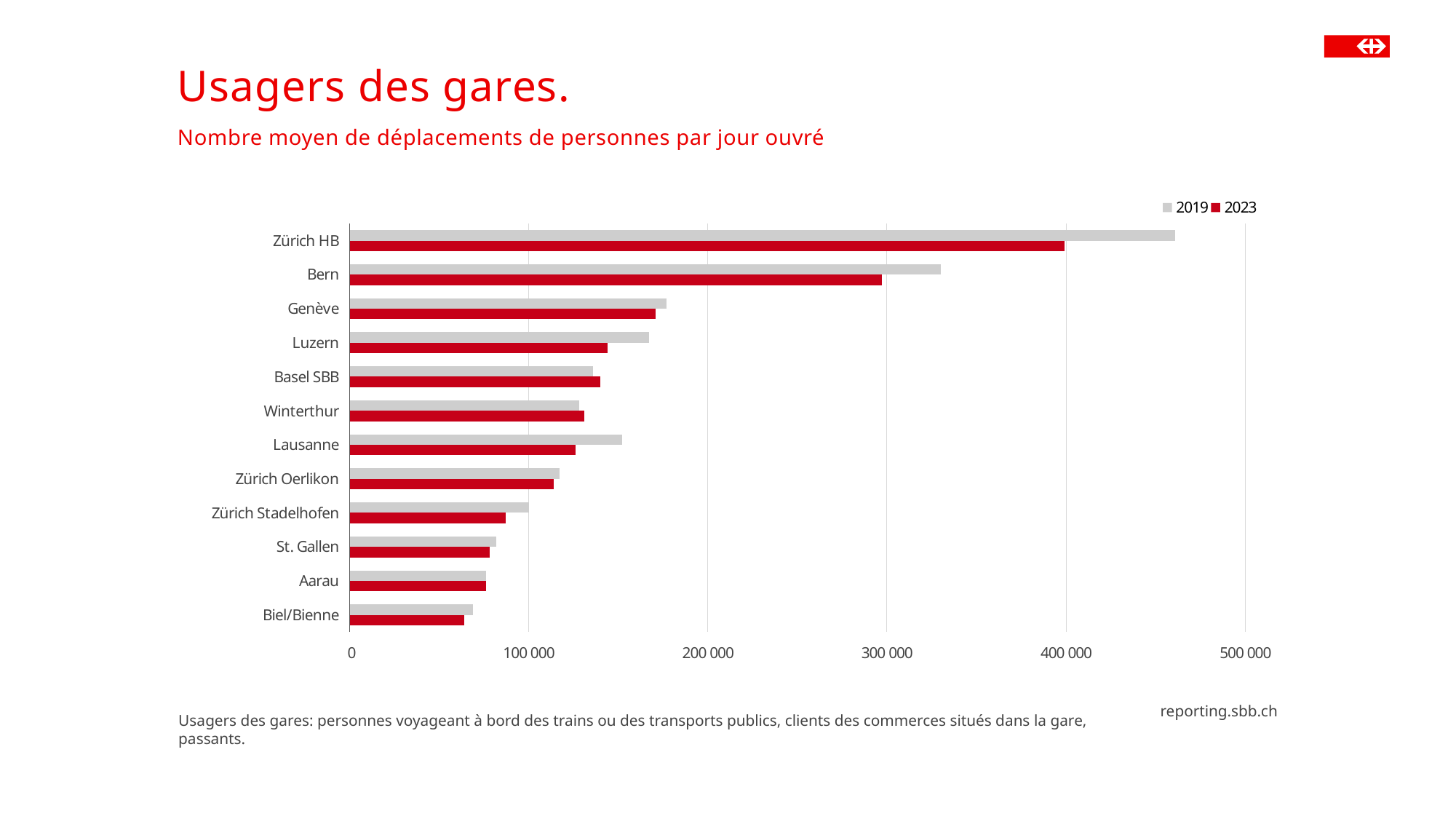
How many series does the legend list? 2 Is the 2019 value for Zürich HB greater or less than 400 000? greater Is the 2023 value for Genève greater or less than 200 000? less Is the 2019 value for Bern greater or less than 300 000? greater Which station has the lowest value for 2023? Biel/Bienne Which station has the highest value for 2023? Zürich HB What kind of chart is shown on the slide? bar chart What is the title of the chart on the slide? Usagers des gares. How many stations are shown on the chart? 12 Which is larger for 2023: Genève or Luzern? Genève For Lausanne, which is larger: the 2019 value or the 2023 value? 2019